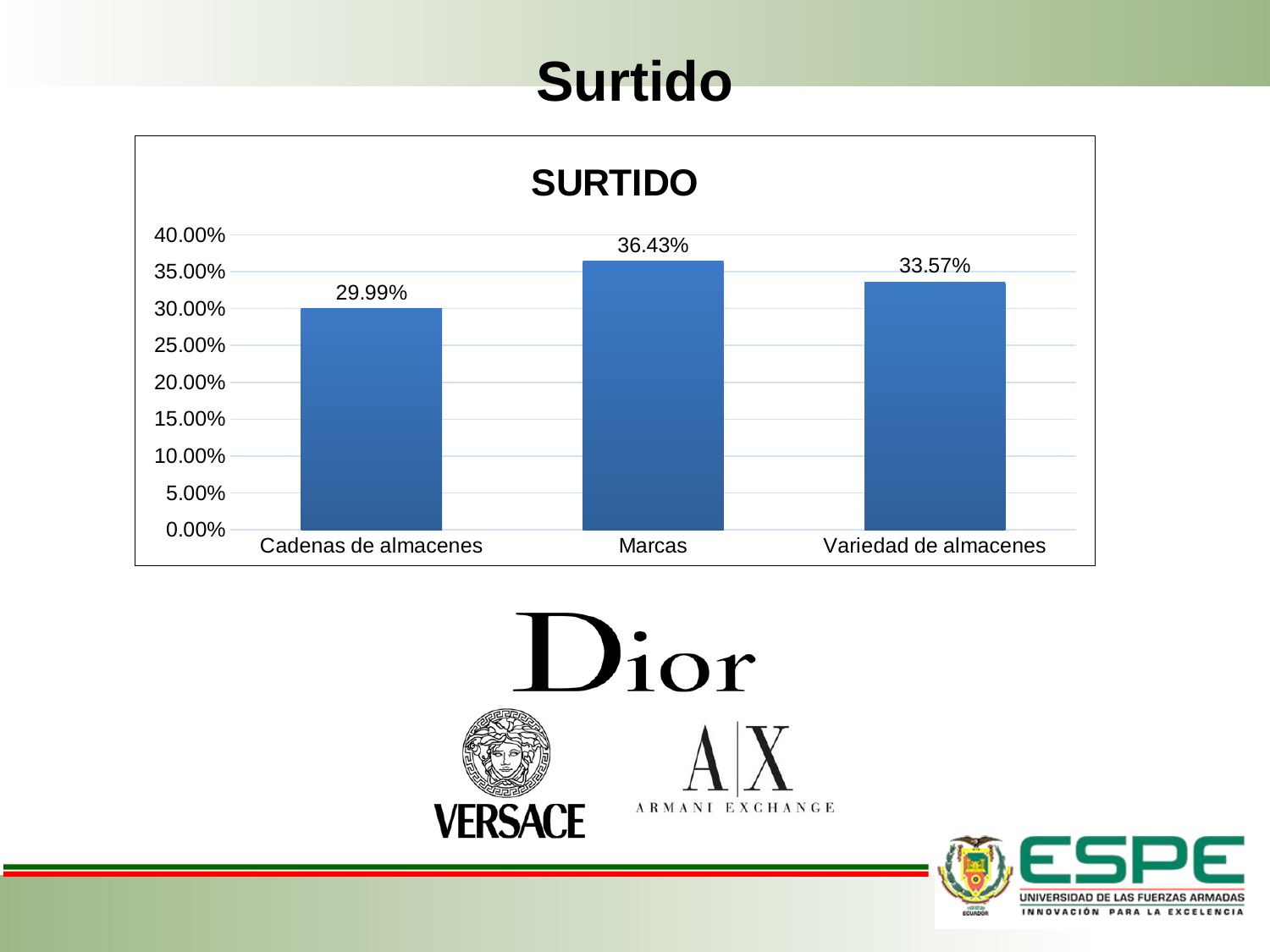
What is the value for Marcas? 36.43% Which is larger, the value for Variedad de almacenes or the value for Cadenas de almacenes? Variedad de almacenes What is the value for Cadenas de almacenes? 29.99% What is the title of the chart? SURTIDO What is the difference between the values for Marcas and Cadenas de almacenes? 6.44% Is the value for Cadenas de almacenes greater or less than 35.00%? less Which category has the highest value? Marcas What is the difference between the values for Marcas and Variedad de almacenes? 2.86% How many categories are shown on the x axis? 3 What kind of chart is shown on the slide? bar chart What is the value for Variedad de almacenes? 33.57% Which category has the lowest value? Cadenas de almacenes